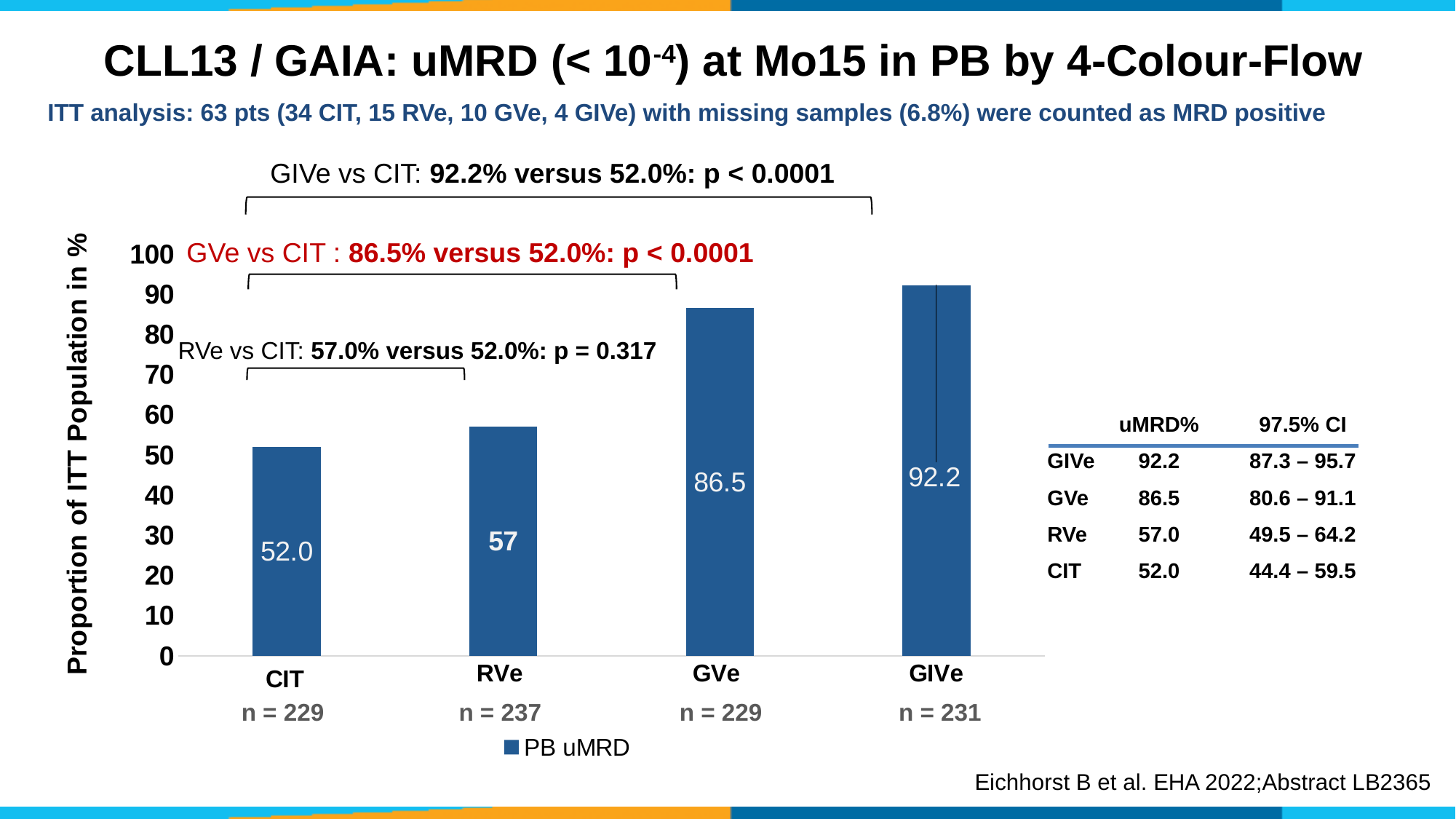
What is the label of the y axis of the chart? Proportion of ITT Population in % Which treatment arm has the highest PB uMRD value? GIVe What is the PB uMRD value for GIVe? 92.2 Which treatment arm has the lowest PB uMRD value? CIT Which has a larger PB uMRD value, GVe or RVe? GVe What is the PB uMRD value for RVe? 57 What is the difference between the PB uMRD values for GIVe and CIT? 40.2 How many treatment arms are shown on the x axis of the chart? 4 What is the PB uMRD value for GVe? 86.5 What is the PB uMRD value for CIT? 52.0 What is the difference between the PB uMRD values for GVe and RVe? 29.5 What kind of chart is shown on the slide? Bar chart